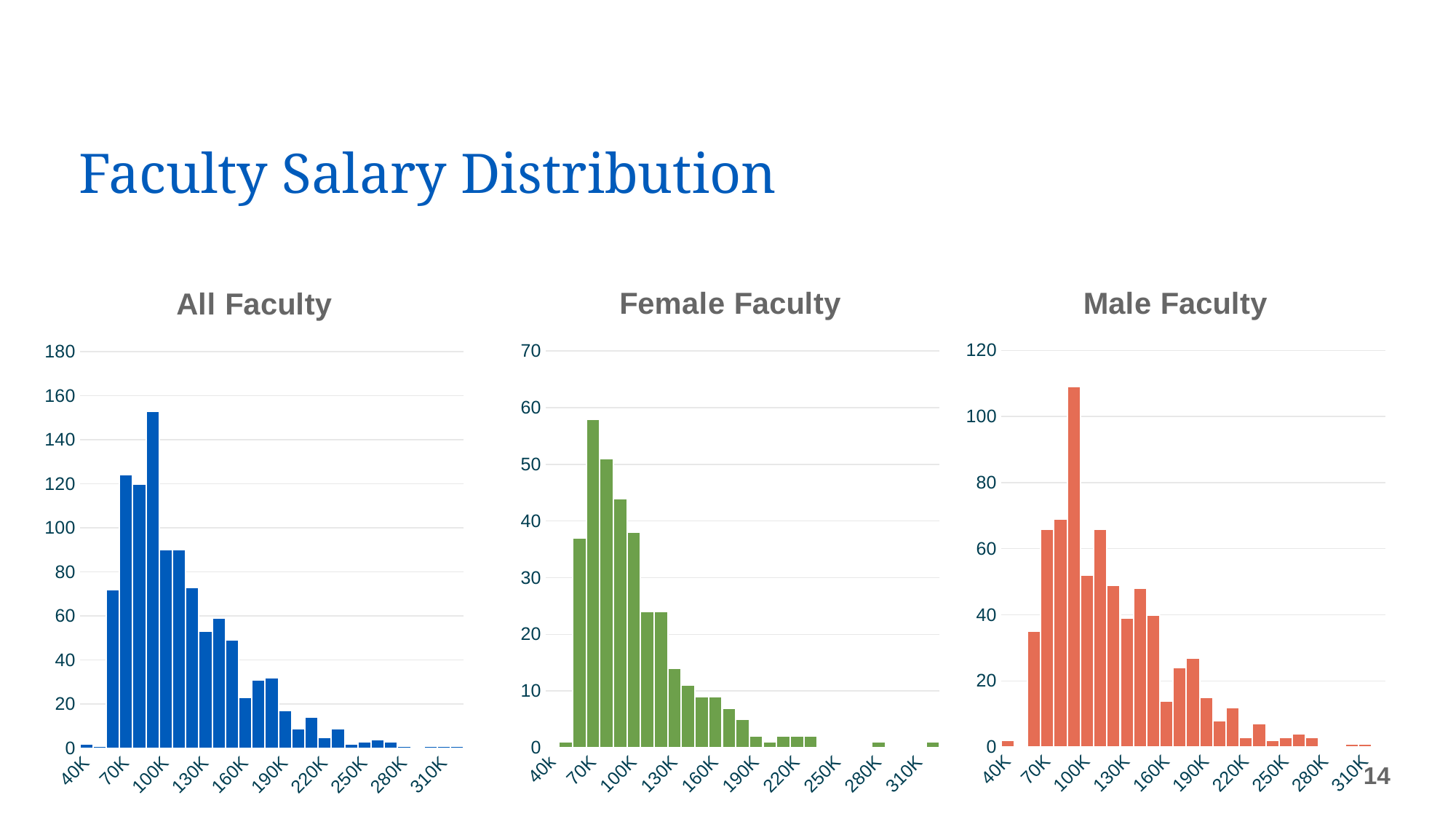
What kind of chart is the All Faculty chart? bar chart What is the highest value shown on the y axis of the Female Faculty chart? 70 In the All Faculty chart, is the value of the bar at 100K greater or less than 140? less In the Male Faculty chart, which of the bars at 70K and 100K is taller? 70K How many charts are shown on the slide? 3 In the Male Faculty chart, is the value of the bar at 190K greater or less than 20? less In the Male Faculty chart, is the value of the bar at 100K greater or less than 100? less In the All Faculty chart, do the bar values rise or fall moving from 100K to 310K along the x axis? fall